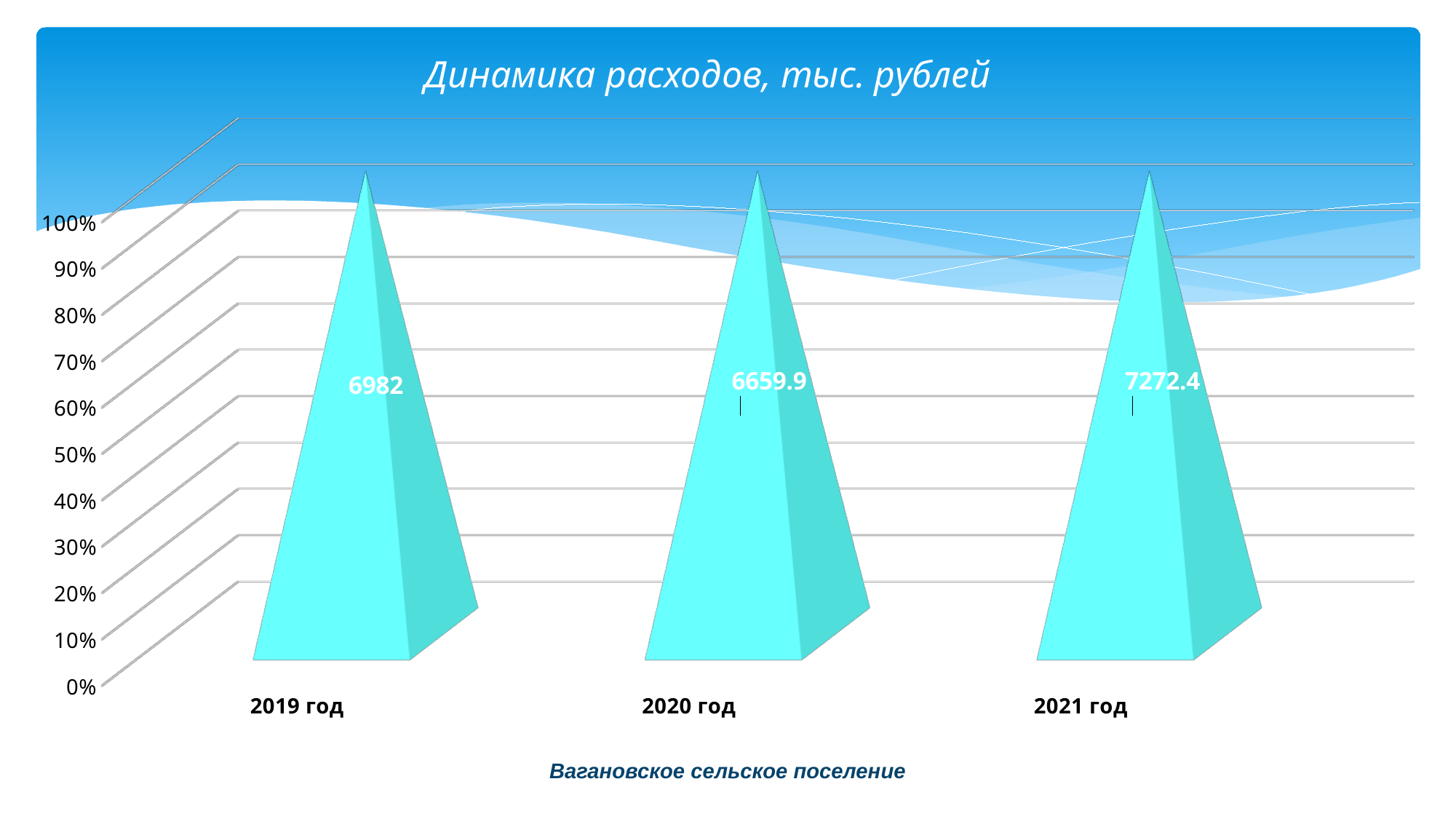
What is the value shown for 2021 год? 7272.4 What is the difference between the values for 2019 год and 2020 год? 322.1 What is the value shown for 2019 год? 6982 Which year has the highest value? 2021 год Which year has the lowest value? 2020 год What kind of chart is this? bar chart What is the difference between the values for 2021 год and 2020 год? 612.5 How many years are shown on the chart? 3 What is the value shown for 2020 год? 6659.9 What is the difference between the values for 2021 год and 2019 год? 290.4 Which is larger, the value for 2019 год or the value for 2020 год? 2019 год What is the title of the chart? Динамика расходов, тыс. рублей